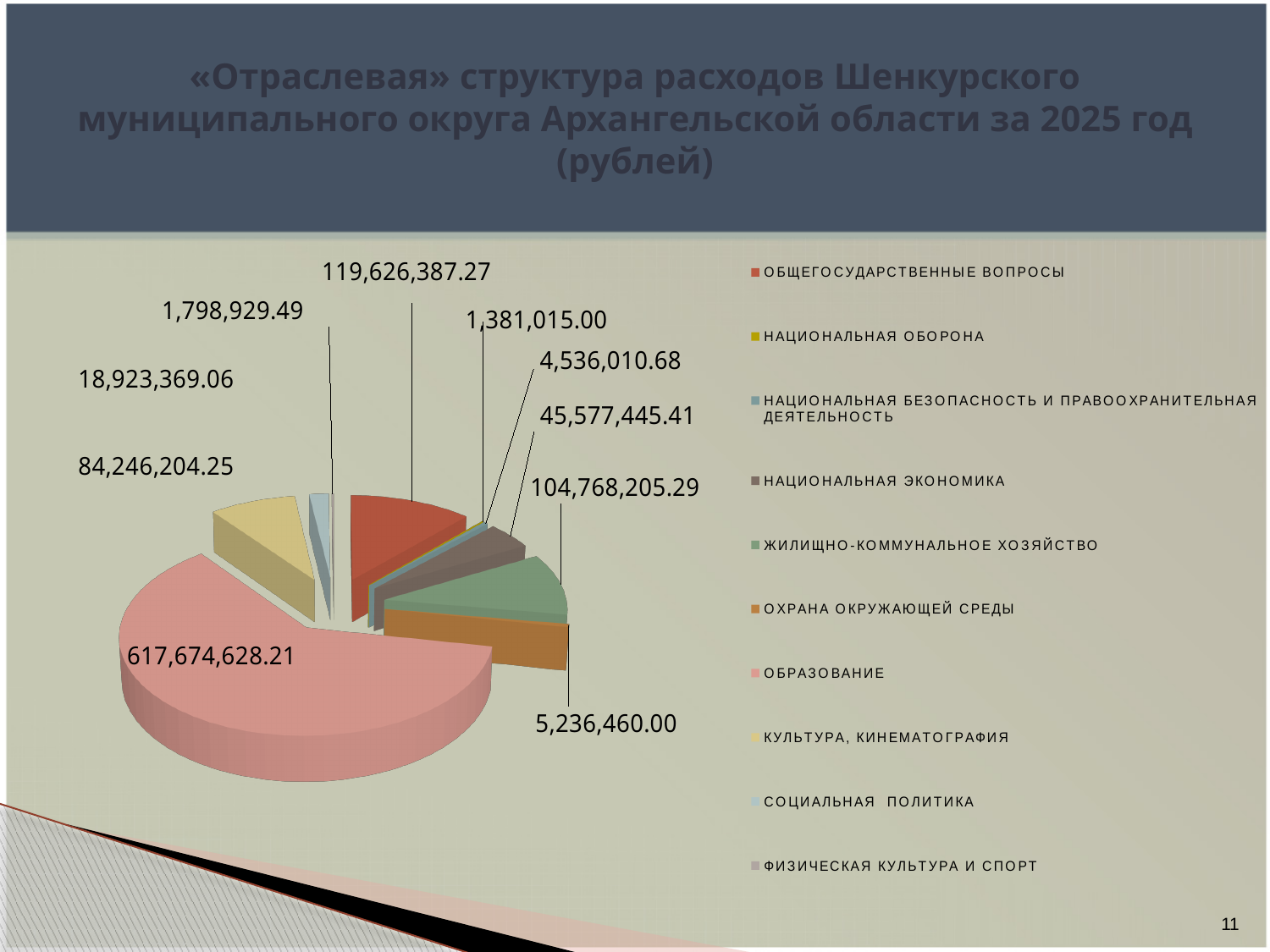
What is the value of the largest slice (ОБРАЗОВАНИЕ)? 617,674,628.21 How many entries does the legend list? 10 Which category has the largest slice in the pie chart? ОБРАЗОВАНИЕ What is the difference between the values 119,626,387.27 and 104,768,205.29? 14,858,181.98 Which is larger: the value for КУЛЬТУРА, КИНЕМАТОГРАФИЯ or the value for НАЦИОНАЛЬНАЯ ЭКОНОМИКА? КУЛЬТУРА, КИНЕМАТОГРАФИЯ What is the value for ЖИЛИЩНО-КОММУНАЛЬНОЕ ХОЗЯЙСТВО? 104,768,205.29 What unit is given in parentheses in the chart title? рублей What is the value for КУЛЬТУРА, КИНЕМАТОГРАФИЯ? 84,246,204.25 What is the value for ОБЩЕГОСУДАРСТВЕННЫЕ ВОПРОСЫ? 119,626,387.27 How many slices does the pie chart have? 10 What is the smallest value printed on the pie chart? 1,381,015.00 What kind of chart is shown on the slide? pie chart